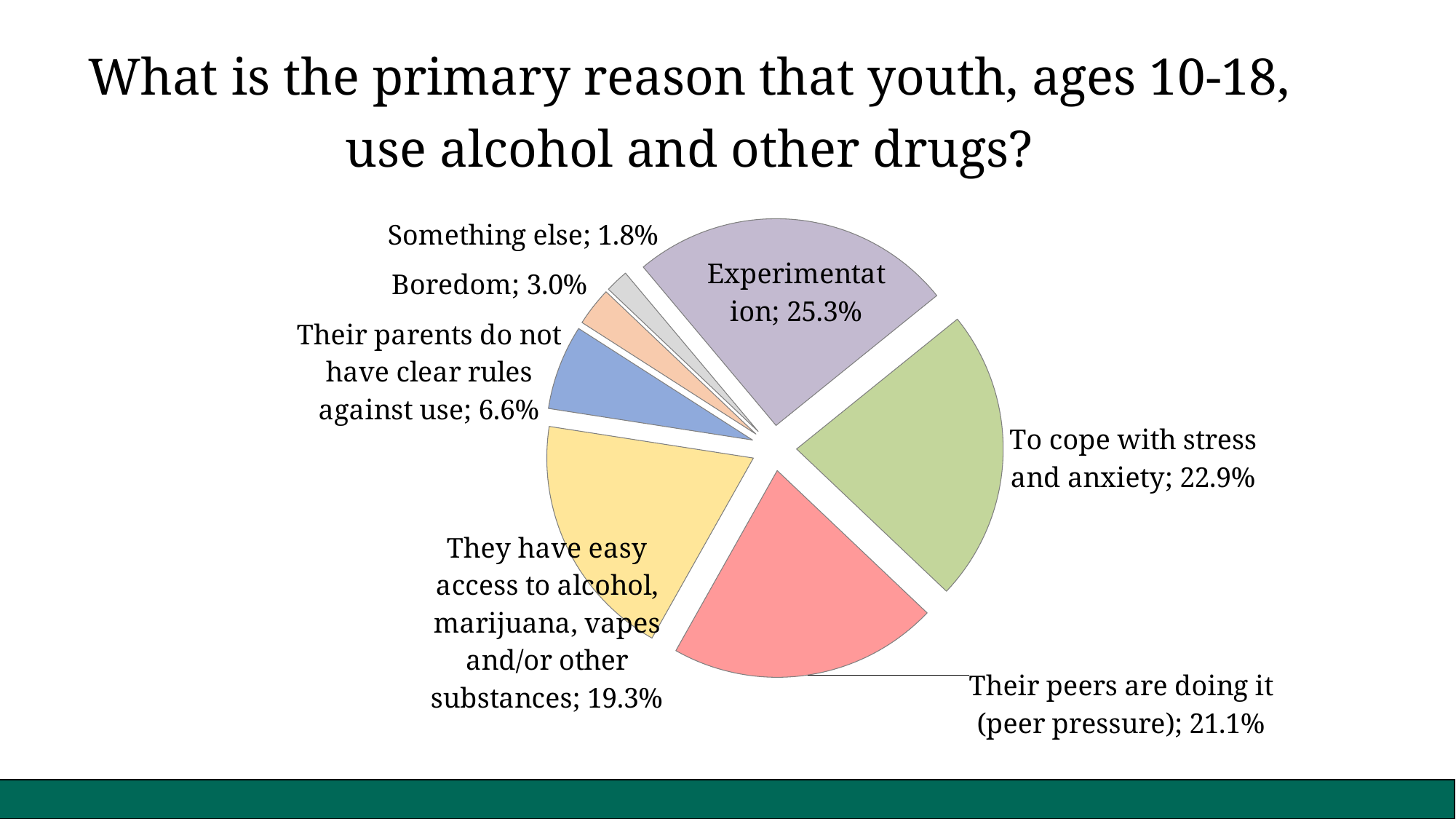
Which reason has the largest share of the pie? Experimentation What is the combined share of "Boredom" and "Something else"? 4.8% What is the value for "Boredom"? 3.0% What kind of chart is shown on the slide? Pie chart What is the value for "Their peers are doing it (peer pressure)"? 21.1% How many slices does the pie chart have? 7 What percentage of the pie is labelled "Experimentation"? 25.3% Which reason has the smallest share of the pie? Something else What is the difference between the "Experimentation" share and the "To cope with stress and anxiety" share? 2.4% What is the value for "To cope with stress and anxiety"? 22.9% Which is larger: "Their parents do not have clear rules against use" or "Boredom"? Their parents do not have clear rules against use What is the title of the chart on the slide? What is the primary reason that youth, ages 10-18, use alcohol and other drugs?